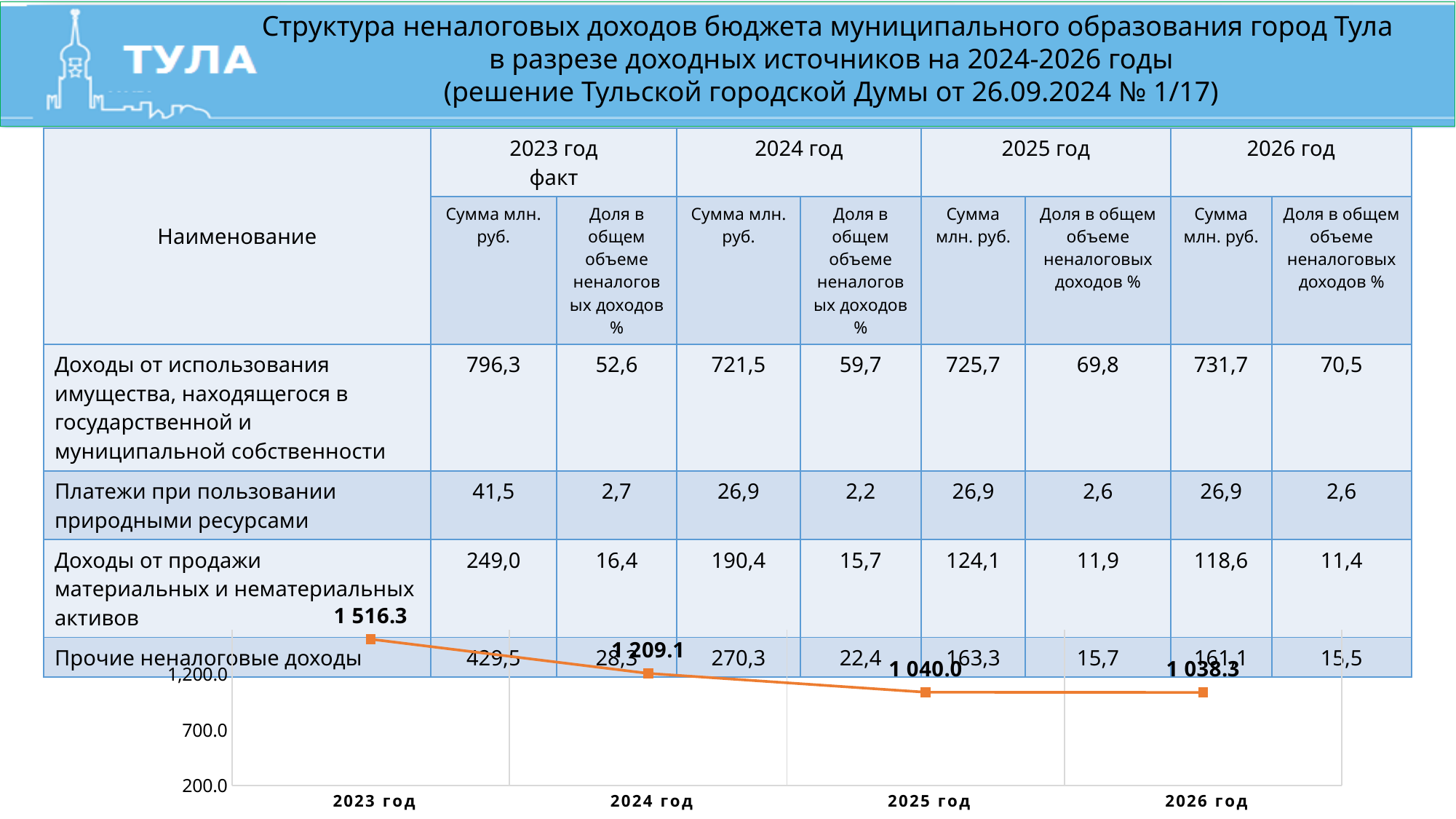
In the line chart, which year has the highest value? 2023 год In the line chart, what is the difference between the values for 2023 год and 2026 год? 478.0 In the line chart, which is larger: the value for 2024 год or the value for 2025 год? 2024 год In the line chart, what is the value for 2025 год? 1 040.0 In the line chart, what is the value for 2023 год? 1 516.3 In the line chart, what is the difference between the values for 2023 год and 2024 год? 307.2 In the line chart, what is the value for 2026 год? 1 038.3 In the line chart, what is the value for 2024 год? 1 209.1 In the line chart, which year has the lowest value? 2026 год In the line chart, is the value for 2025 год greater or less than 1,200.0? less How many data points are plotted in the line chart? 4 What type of chart is shown at the bottom of the slide? line chart